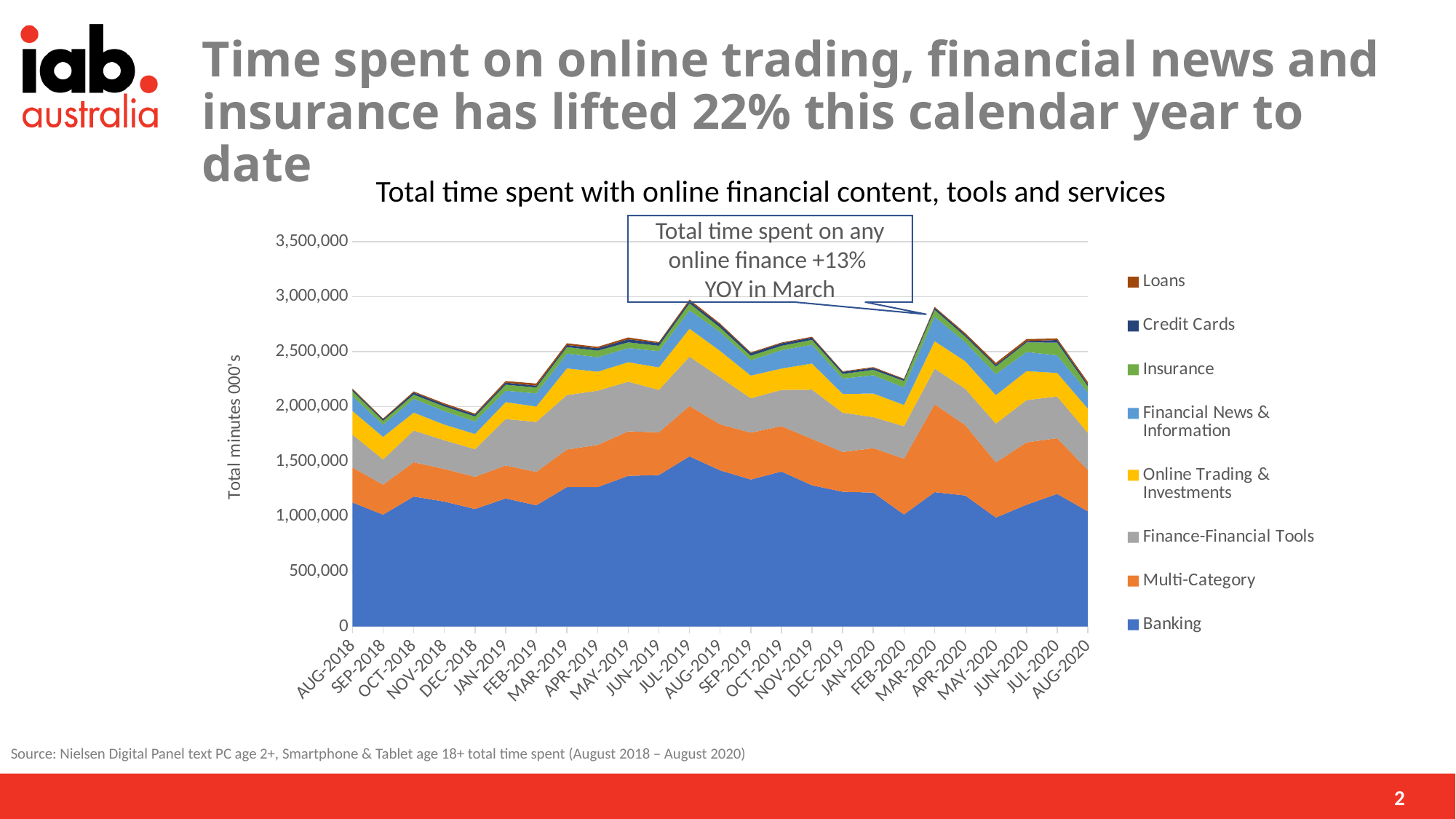
Is the total time spent in JUL-2019 larger or smaller than in SEP-2018? larger How many series does the legend list? 8 Is the Banking value in AUG-2018 greater or less than 1,000,000? greater How many months are plotted along the x axis? 25 Is the total time spent in SEP-2018 greater or less than 2,000,000? less Which series occupies the largest area of the chart? Banking What is the label on the y axis? Total minutes 000's What kind of chart is shown on the slide? Stacked area chart What is the title of the chart? Total time spent with online financial content, tools and services Is the total time spent in AUG-2018 greater or less than 2,000,000? greater Does the total time spent generally rise or fall from AUG-2018 to JUL-2019? rise